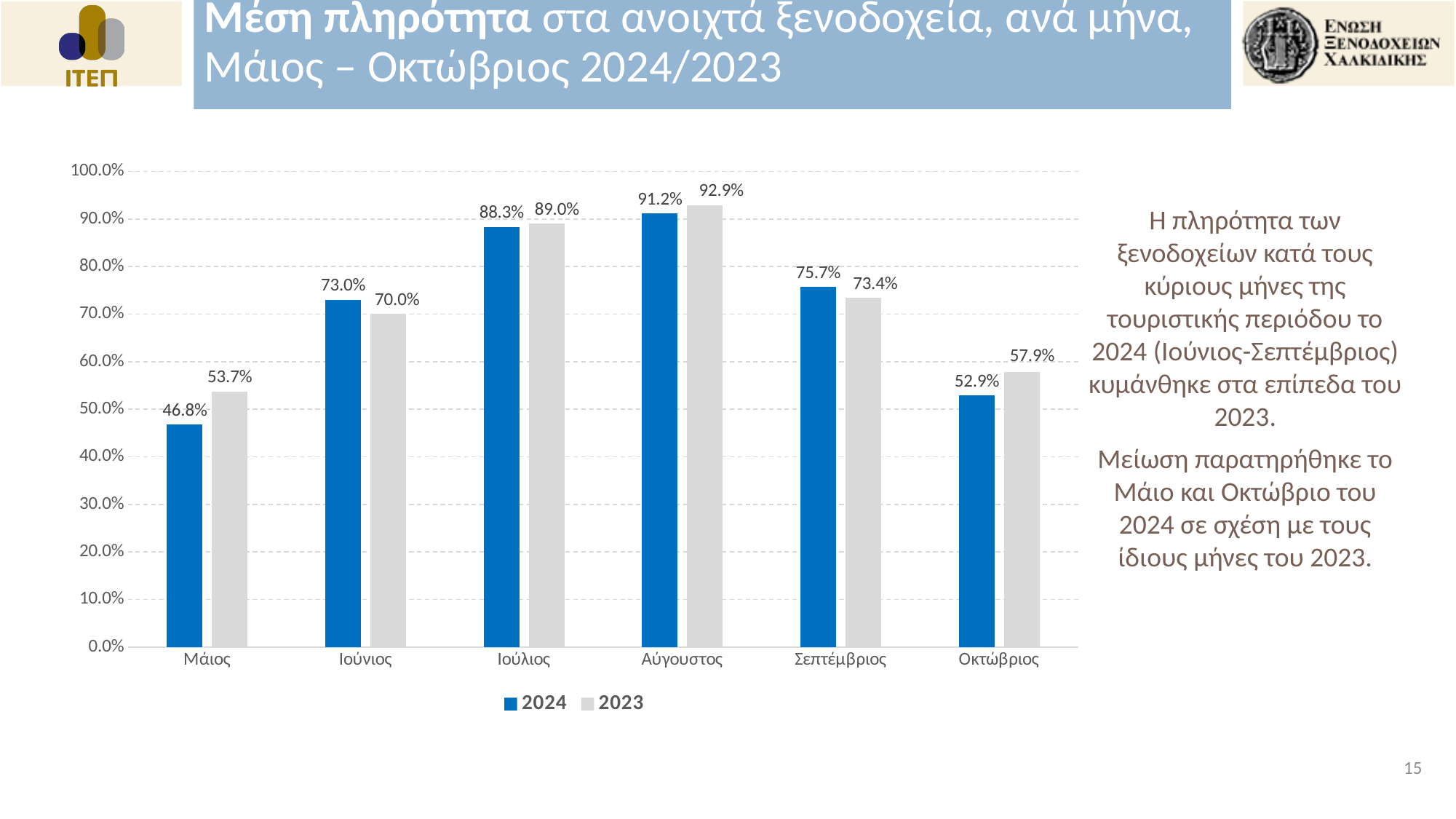
What kind of chart is shown on the slide? Bar chart Which month has the lowest 2023 value? Μάιος Which month has the highest 2024 value? Αύγουστος What is the 2024 value for Ιούλιος? 88.3% Which colour represents the 2024 series in the legend? Blue Is the 2024 value for Σεπτέμβριος greater or less than 70.0%? greater What is the difference between the 2023 and 2024 values for Αύγουστος? 1.7% What is the 2024 value for Οκτώβριος? 52.9% What is the 2023 value for Μάιος? 53.7% How many months are shown on the x axis? 6 Which is larger for Ιούνιος, the 2024 value or the 2023 value? 2024 How many series does the legend list? 2